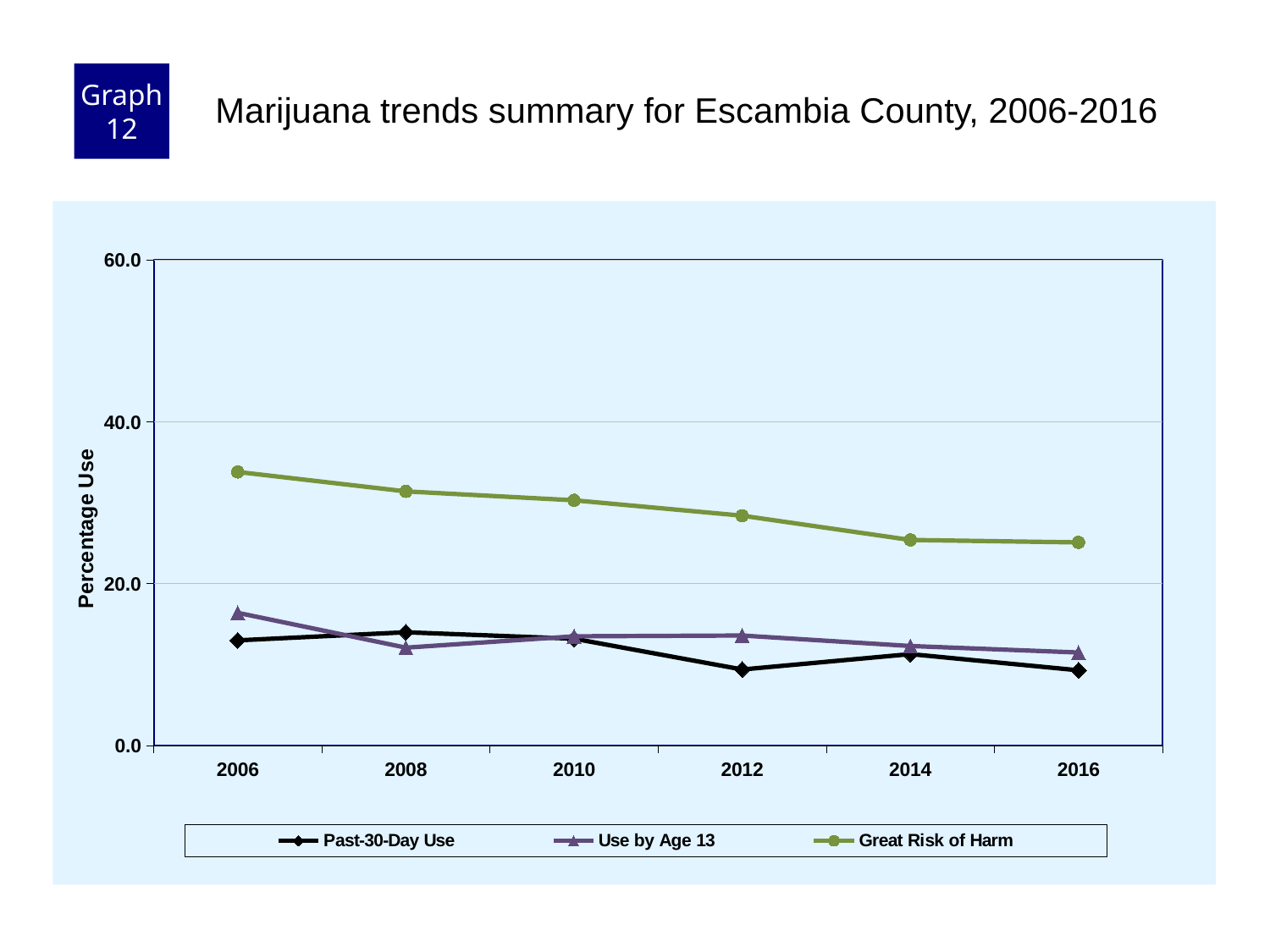
Does the Great Risk of Harm line rise or fall from 2006 to 2016? Falls In 2006, which is larger: Use by Age 13 or Past-30-Day Use? Use by Age 13 In which year is the Use by Age 13 value highest? 2006 How many years are plotted along the x axis? 6 In 2008, which is larger: Past-30-Day Use or Use by Age 13? Past-30-Day Use What kind of chart is shown on the slide? Line chart How many series does the legend list? 3 Is the value for Past-30-Day Use in 2012 greater or less than 20.0? less In which year is the Great Risk of Harm value highest? 2006 Is the value for Great Risk of Harm in 2016 greater or less than 20.0? greater What is the label on the y axis? Percentage Use Is the value for Great Risk of Harm in 2006 greater or less than 40.0? less